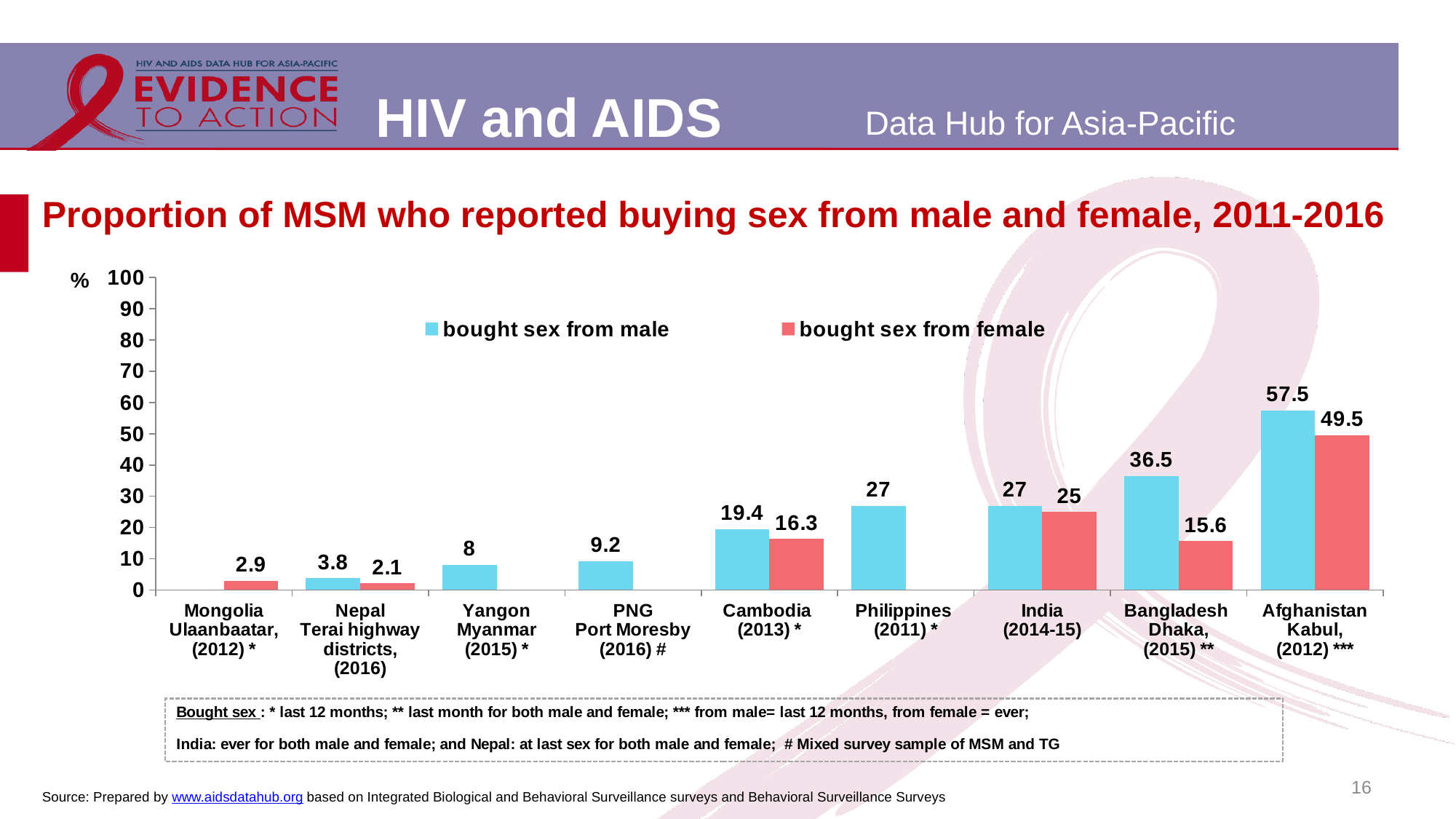
Which site has the highest proportion of MSM who bought sex from male? Afghanistan Kabul (2012) In Cambodia (2013), which is larger: bought sex from male or bought sex from female? bought sex from male What kind of chart is shown on the slide? bar chart Which site has the lowest value for bought sex from female? Nepal Terai highway districts (2016) What is the proportion of MSM who bought sex from female in Bangladesh Dhaka (2015)? 15.6 What is the proportion of MSM who bought sex from male in Afghanistan Kabul (2012)? 57.5 How many series does the legend list? 2 What is the value for bought sex from male in PNG Port Moresby (2016)? 9.2 Is the value for bought sex from male in India (2014-15) greater or less than 20? greater Which colour represents the series 'bought sex from female'? red What is the difference between bought sex from male and bought sex from female in Bangladesh Dhaka (2015)? 20.9 How many countries or sites are shown on the x axis? 9